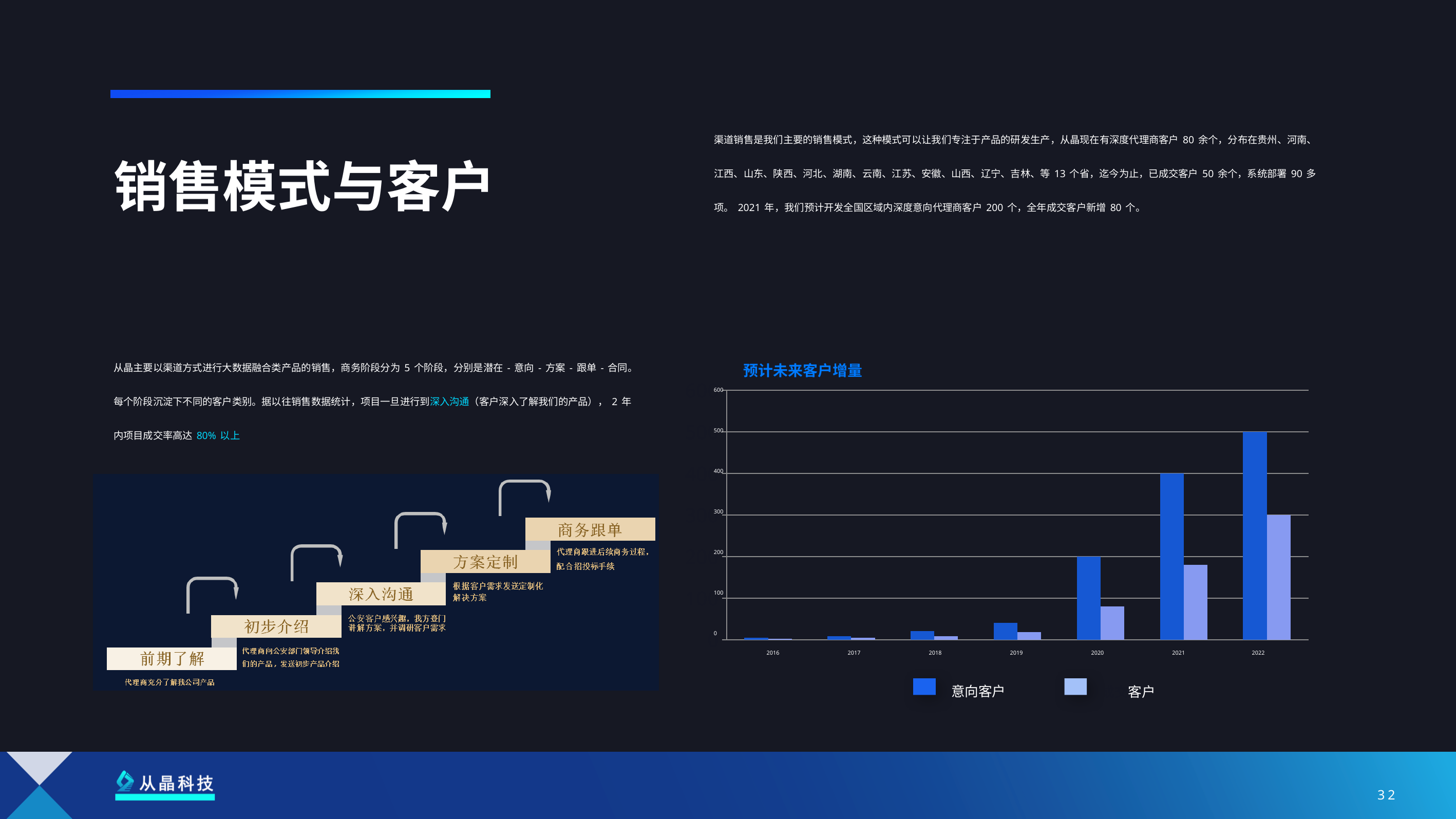
What kind of chart is shown under the title 预计未来客户增量? bar chart What is the title of the bar chart on the right side of the slide? 预计未来客户增量 In the 预计未来客户增量 chart, is the value for 意向客户 in 2022 greater or less than 400? greater What are the two legend entries of the 预计未来客户增量 chart? 意向客户 and 客户 In the 预计未来客户增量 chart, which year has the highest value for 意向客户? 2022 How many series does the legend of the 预计未来客户增量 chart list? 2 In the 预计未来客户增量 chart, is the value for 意向客户 in 2021 greater or less than 300? greater In the 预计未来客户增量 chart, which year has the highest value for 客户? 2022 In the 预计未来客户增量 chart, for 2021, which is larger: 意向客户 or 客户? 意向客户 In the 预计未来客户增量 chart, is the value for 客户 in 2020 greater or less than 100? less In the 预计未来客户增量 chart, do the 意向客户 values rise or fall from 2016 to 2022? rise How many years are shown on the x axis of the 预计未来客户增量 chart? 7